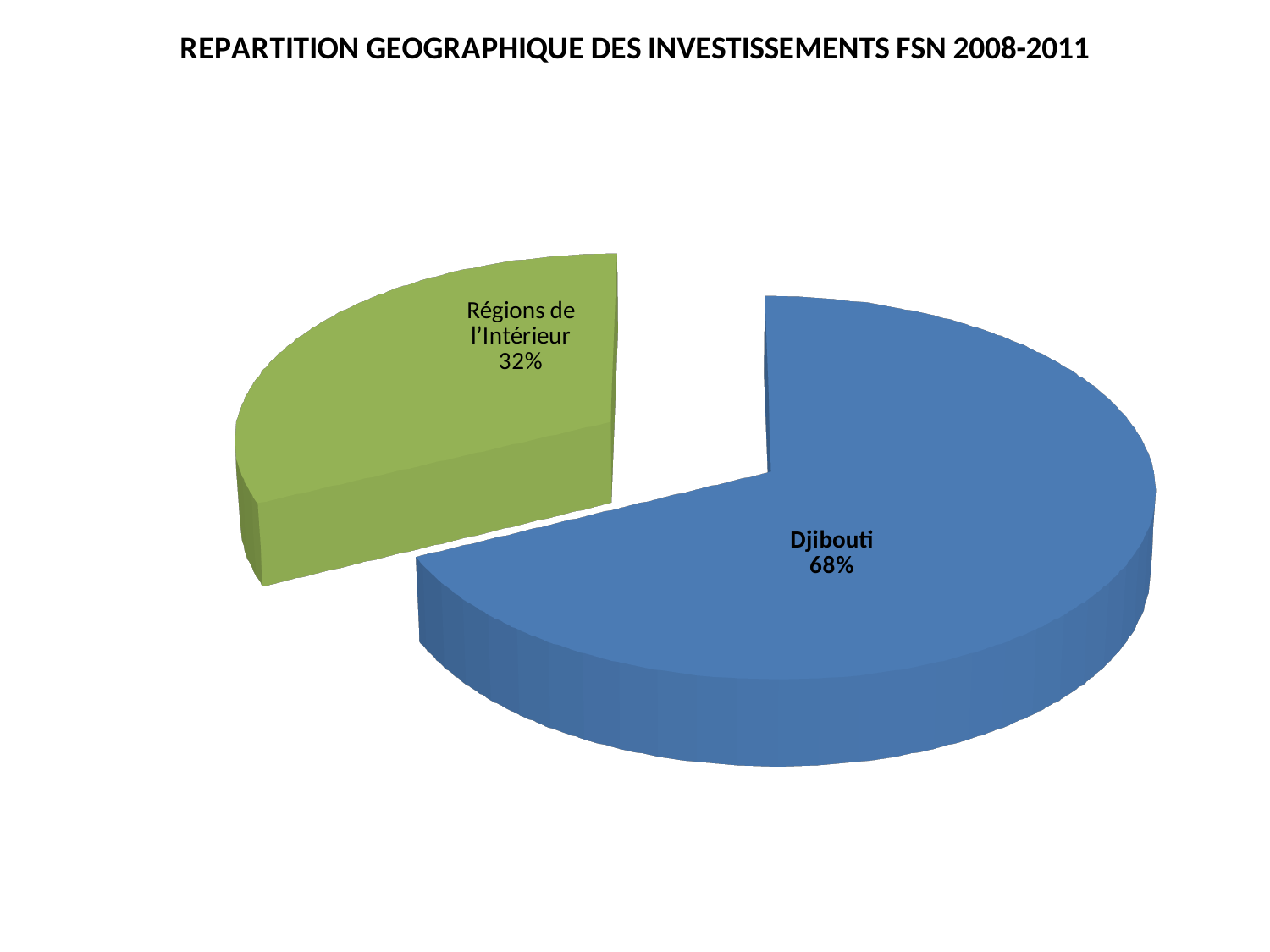
What share of the pie does Djibouti represent? 68% Which slice is the smallest? Régions de l'Intérieur What is the total of the two slices' percentages? 100% How many slices does the pie chart have? 2 What is the title of the chart? REPARTITION GEOGRAPHIQUE DES INVESTISSEMENTS FSN 2008-2011 What is the difference in percentage points between Djibouti and Régions de l'Intérieur? 36 Which slice is the largest? Djibouti What colour is the Djibouti slice? Blue What share of the pie does Régions de l'Intérieur represent? 32% What kind of chart is shown on the slide? Pie chart Which is larger, the share for Djibouti or the share for Régions de l'Intérieur? Djibouti